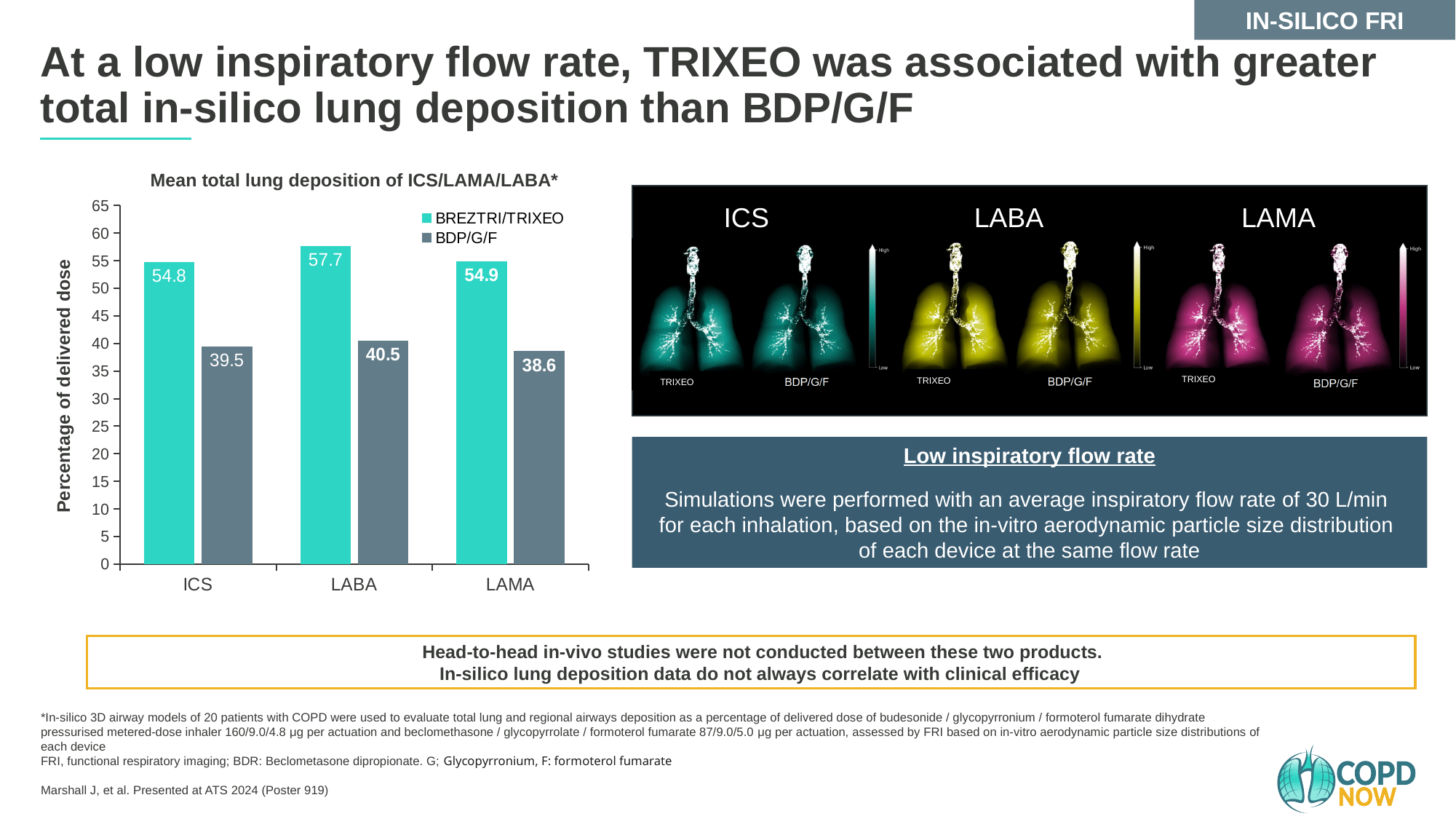
How many categories are shown on the x axis of the chart? 3 Which category has the lowest BDP/G/F value? LAMA What is the difference between the BREZTRI/TRIXEO and BDP/G/F values in the ICS category? 15.3 How many series does the chart legend list? 2 What is the difference between the BREZTRI/TRIXEO and BDP/G/F values in the LAMA category? 16.3 Is the BDP/G/F value for ICS greater or less than 45? less What is the value for BDP/G/F in the LAMA category? 38.6 What is the mean total lung deposition for BDP/G/F in the LABA category? 40.5 What type of chart is used to show mean total lung deposition? Bar chart What is the mean total lung deposition for BREZTRI/TRIXEO in the ICS category? 54.8 Which category has the highest BREZTRI/TRIXEO value? LABA In the LABA category, which series has the larger value, BREZTRI/TRIXEO or BDP/G/F? BREZTRI/TRIXEO